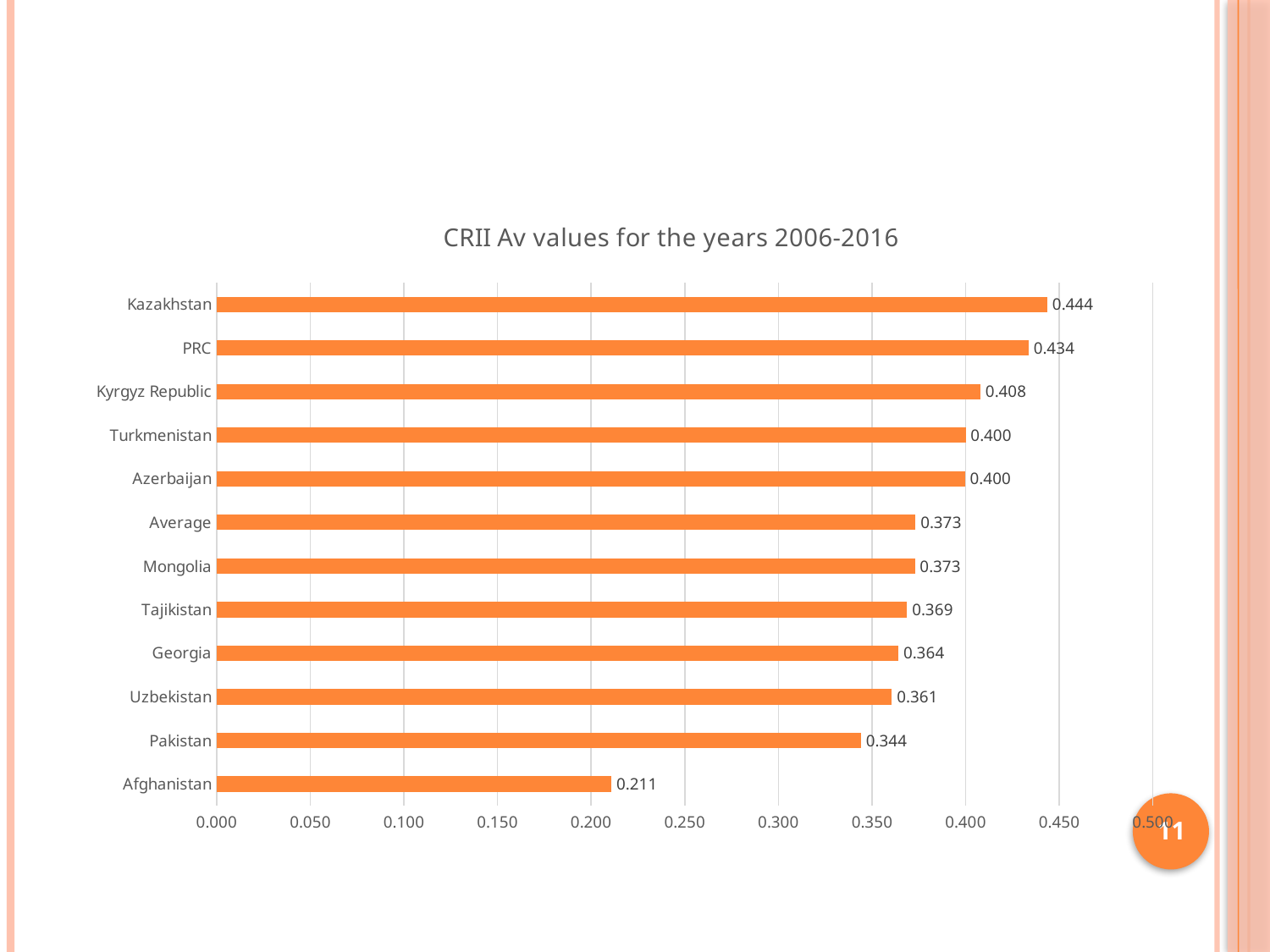
What is the title of the chart? CRII Av values for the years 2006-2016 Is the value for Georgia greater or less than 0.400? less What is the CRII average value for Afghanistan? 0.211 What is the difference between the values for Pakistan and Afghanistan? 0.133 What is the difference between the values for Kazakhstan and PRC? 0.010 Which category has the highest value? Kazakhstan How many bars are shown in the chart? 12 Which category has the lowest value? Afghanistan What is the value shown for Mongolia? 0.373 What kind of chart is shown on the slide? bar chart What is the CRII average value for Kazakhstan? 0.444 Which has a larger value, Kyrgyz Republic or Uzbekistan? Kyrgyz Republic